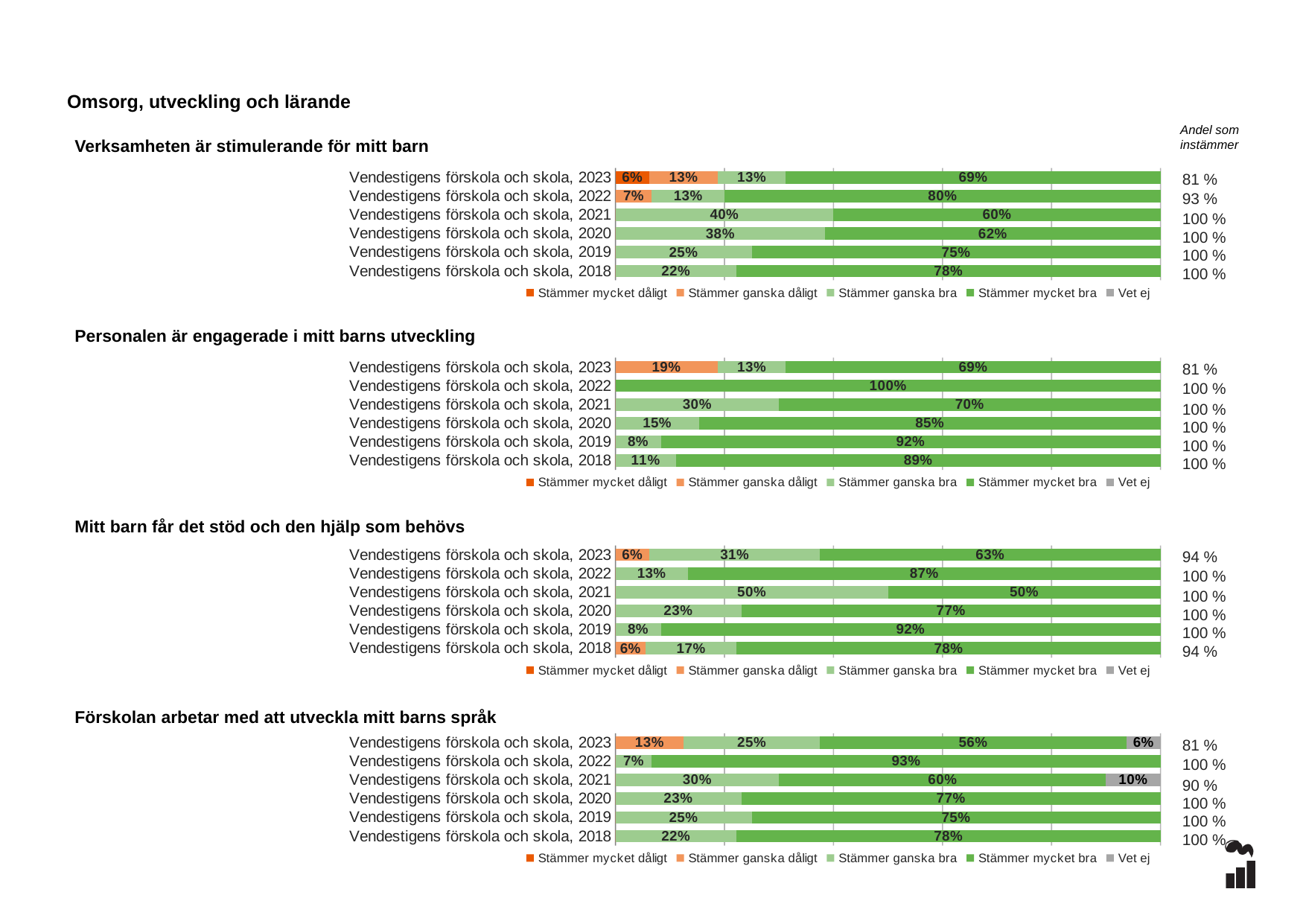
In the chart 'Personalen är engagerade i mitt barns utveckling', which year has the lowest 'Stämmer mycket bra' value? 2023 How many series does the legend of the chart 'Förskolan arbetar med att utveckla mitt barns språk' list? 5 In the chart 'Personalen är engagerade i mitt barns utveckling', is the 'Stämmer mycket bra' value larger for 2019 or 2018? 2019 What kind of chart is 'Verksamheten är stimulerande för mitt barn'? Stacked bar chart In the chart 'Verksamheten är stimulerande för mitt barn', what is the 'Stämmer mycket bra' value for Vendestigens förskola och skola, 2022? 80% In the chart 'Mitt barn får det stöd och den hjälp som behövs', what is the difference between the 'Stämmer mycket bra' values for 2019 and 2018? 14% In the chart 'Verksamheten är stimulerande för mitt barn', what is the difference between the 'Stämmer ganska bra' values for 2021 and 2020? 2% In the chart 'Förskolan arbetar med att utveckla mitt barns språk', what is the 'Vet ej' value for 2021? 10% In the chart 'Personalen är engagerade i mitt barns utveckling', what is the 'Stämmer ganska dåligt' value for 2023? 19% In the chart 'Verksamheten är stimulerande för mitt barn', which year has the highest 'Stämmer mycket bra' value? 2022 In the chart 'Mitt barn får det stöd och den hjälp som behövs', what is the 'Stämmer ganska bra' value for 2023? 31% In the chart 'Förskolan arbetar med att utveckla mitt barns språk', which year has the highest 'Stämmer mycket bra' value? 2022